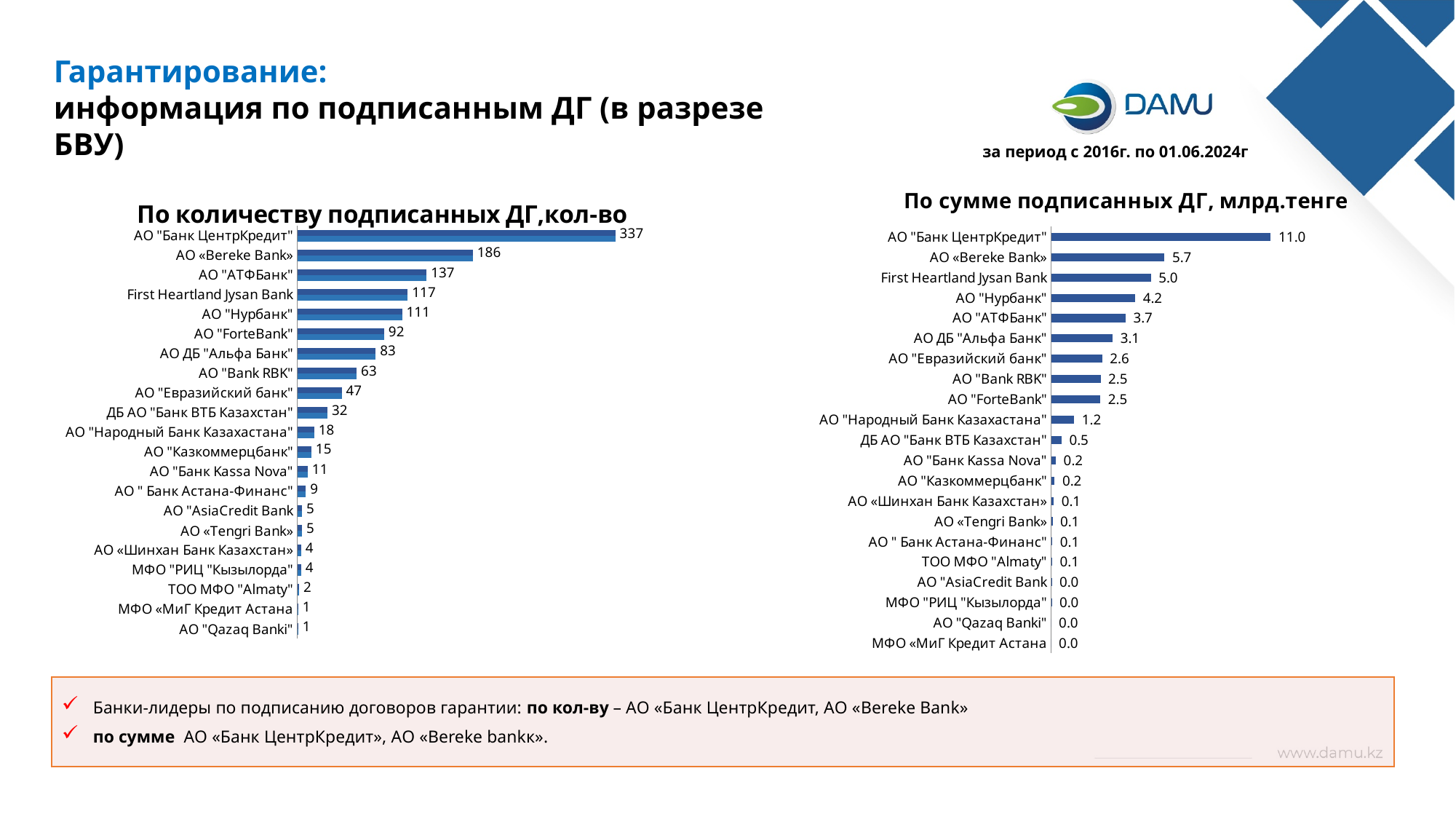
What unit is stated in the title of the right-hand chart? млрд.тенге In the chart "По количеству подписанных ДГ,кол-во", what is the value for АО "АТФБанк"? 137 In the chart "По количеству подписанных ДГ,кол-во", what is the difference between АО "Банк ЦентрКредит" and АО «Bereke Bank»? 151 How many banks are listed in the chart "По количеству подписанных ДГ,кол-во"? 21 In the chart "По сумме подписанных ДГ, млрд.тенге", what is the difference between АО "Банк ЦентрКредит" and АО «Bereke Bank»? 5.3 In the chart "По количеству подписанных ДГ,кол-во", which bank has the highest value? АО "Банк ЦентрКредит" In the chart "По количеству подписанных ДГ,кол-во", which is larger: АО "ForteBank" or АО ДБ "Альфа Банк"? АО "ForteBank" In the chart "По сумме подписанных ДГ, млрд.тенге", what is the value for First Heartland Jysan Bank? 5.0 In the chart "По сумме подписанных ДГ, млрд.тенге", which is larger: АО "Нурбанк" or АО "АТФБанк"? АО "Нурбанк" In the chart "По сумме подписанных ДГ, млрд.тенге", what is the value for АО "Народный Банк Казахастана"? 1.2 In the chart "По сумме подписанных ДГ, млрд.тенге", what is the value for ДБ АО "Банк ВТБ Казахстан"? 0.5 What type of chart is "По количеству подписанных ДГ,кол-во"? Bar chart